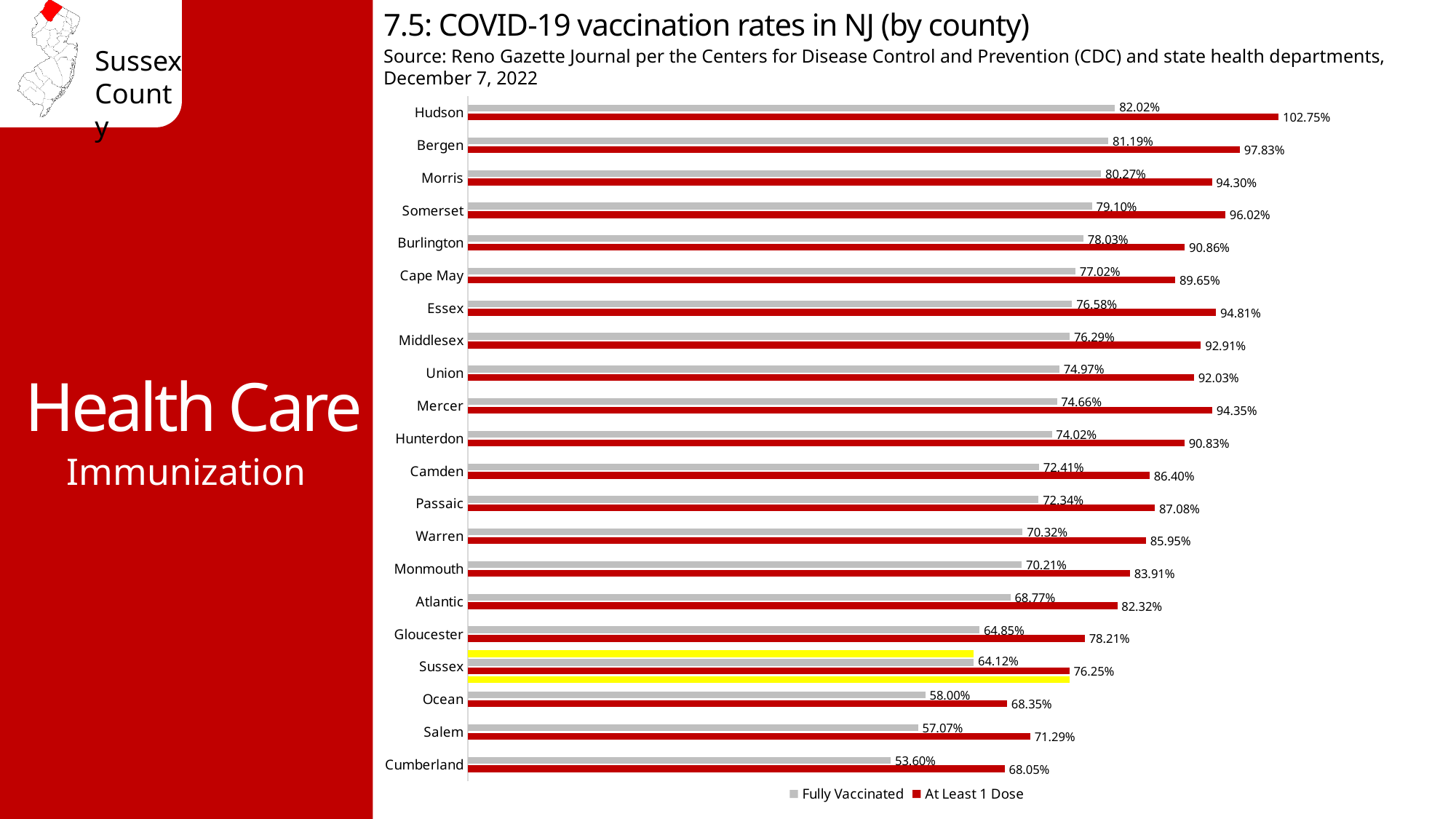
Which county has the lowest At Least 1 Dose rate? Cumberland How many counties are shown in the chart? 21 What is the Fully Vaccinated rate for Cumberland? 53.60% How many series does the legend list? 2 What is the At Least 1 Dose rate for Hudson? 102.75% What is the Fully Vaccinated rate for Sussex? 64.12% What is the difference between the At Least 1 Dose rate and the Fully Vaccinated rate for Sussex? 12.13% Which county's bars are highlighted in yellow? Sussex What kind of chart is shown on the slide? Bar chart How much higher is Salem's At Least 1 Dose rate than Ocean's? 2.94% Which county has the highest Fully Vaccinated rate? Hudson Which has a higher At Least 1 Dose rate, Bergen or Somerset? Bergen